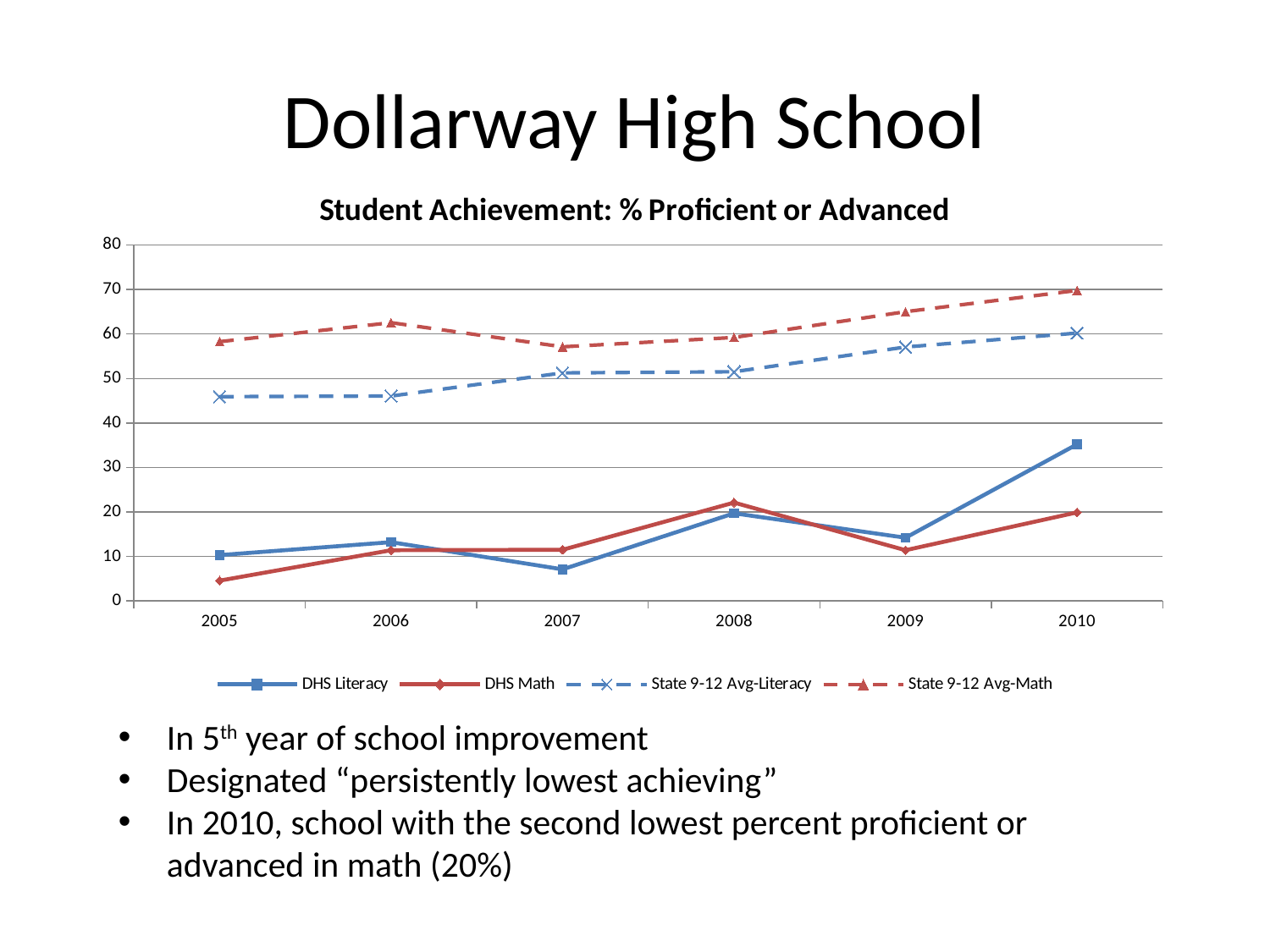
Is the value for DHS Literacy in 2010 greater or less than 30? greater How many years are plotted along the x axis? 6 What is the title of the chart? Student Achievement: % Proficient or Advanced Which series has the highest value in 2010? State 9-12 Avg-Math In which year is DHS Literacy at its highest? 2010 In which year is DHS Literacy at its lowest? 2007 How many series does the legend list? 4 Does State 9-12 Avg-Literacy rise or fall from 2007 to 2010? rise In 2010, which is larger: State 9-12 Avg-Math or State 9-12 Avg-Literacy? State 9-12 Avg-Math What kind of chart is shown on the slide? line chart In which year is DHS Math at its lowest? 2005 Is the value for DHS Math in 2005 greater or less than 10? less